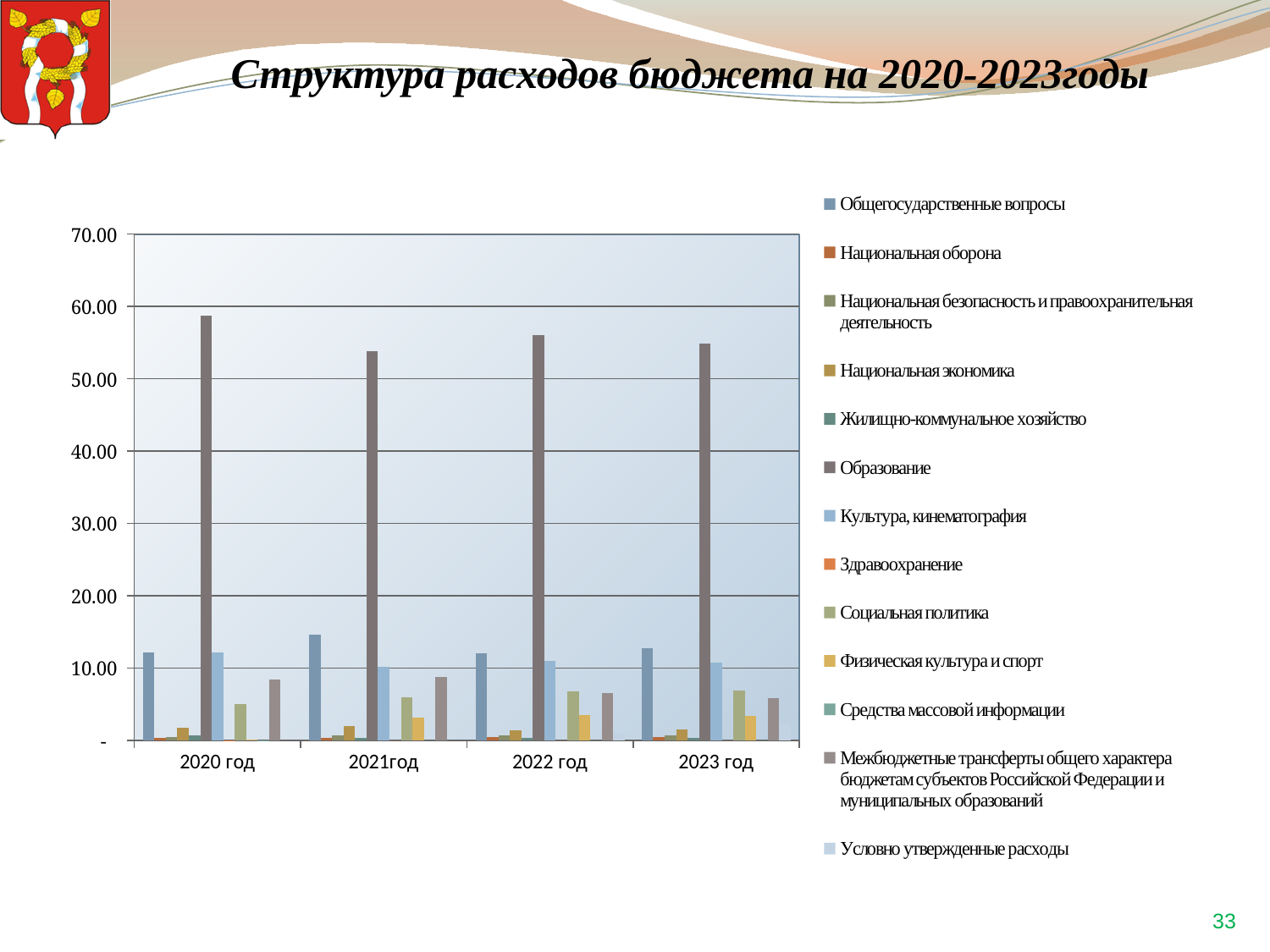
Which series has the highest bar in the 2023 год group? Образование What is the first series listed in the chart legend? Общегосударственные вопросы What is the title of the slide containing the chart? Структура расходов бюджета на 2020-2023годы Is the value for Общегосударственные вопросы in 2021год greater or less than 10.00? greater Which is larger: the value for Образование in 2020 год or in 2021год? 2020 год Is the value for Образование in 2021год greater or less than 60.00? less Which series has the highest bar in the 2020 год group? Образование What kind of chart is shown on the slide? bar chart How many series does the chart legend list? 13 Is the value for Социальная политика in 2020 год greater or less than 10.00? less How many year categories are shown on the x axis of the chart? 4